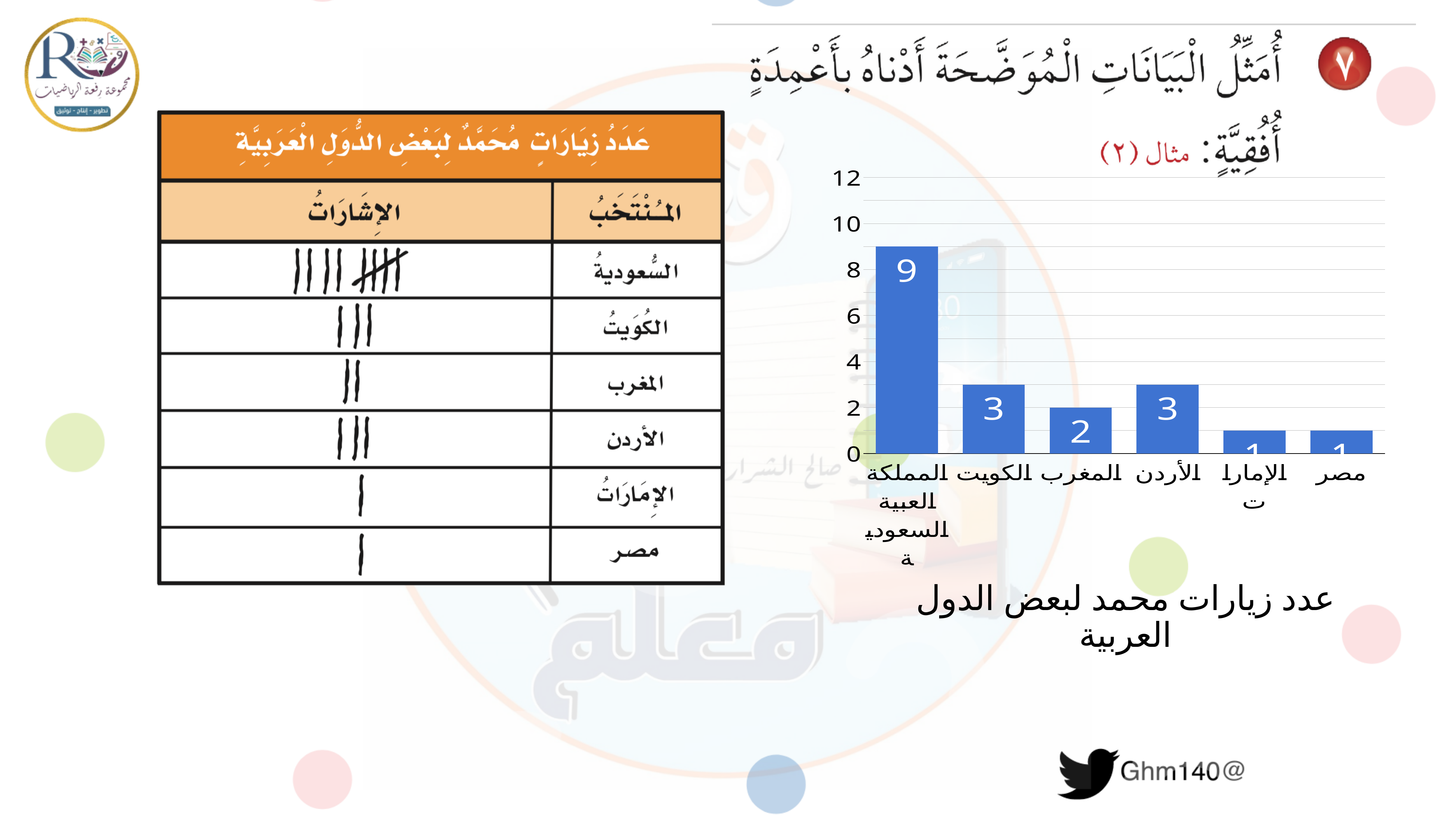
What is the value for المغرب in the bar chart? 2 Which is larger, the value for الأردن or the value for المغرب? الأردن Which country has the highest value in the bar chart? المملكة العربية السعودية What is the difference between the values for المملكة العربية السعودية and الكويت? 6 What is the title of the bar chart? عدد زيارات محمد لبعض الدول العربية What is the highest value shown on the vertical axis of the bar chart? 12 What is the value for المملكة العربية السعودية in the bar chart? 9 What type of chart is shown on the slide? bar chart What is the value for الأردن in the bar chart? 3 What is the value for الكويت in the bar chart? 3 Is the value for المملكة العربية السعودية greater or less than 8? greater How many countries (categories) are shown in the bar chart? 6